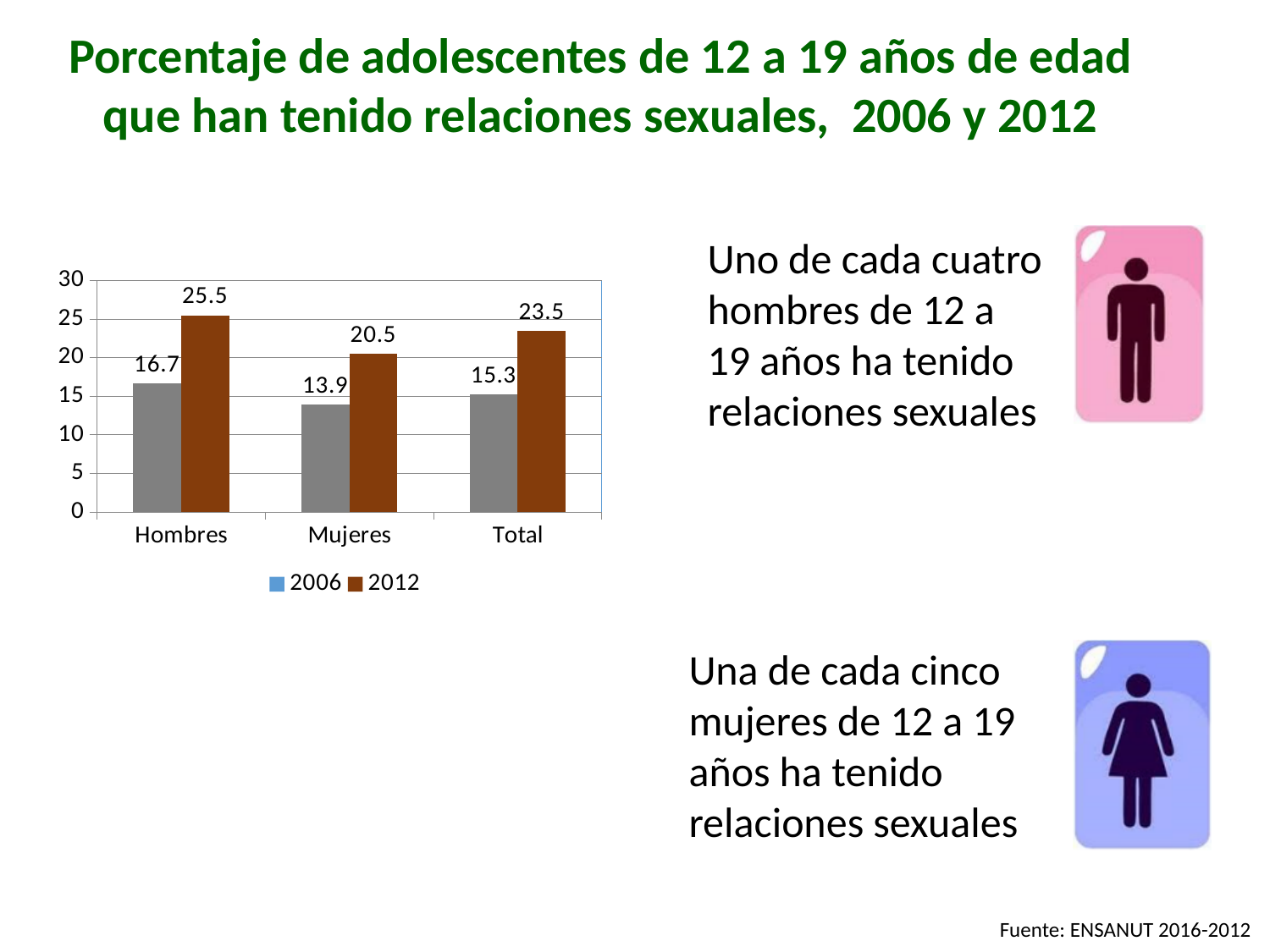
What kind of chart is shown on the slide? Bar chart What is the difference between the 2012 values for Hombres and Mujeres? 5 Which category has the lowest value in the 2006 series? Mujeres What is the value for Hombres in the 2006 series? 16.7 Which is larger, the 2012 value for Total or the 2012 value for Mujeres? Total What is the difference between the 2012 and 2006 values for Hombres? 8.8 What is the value for Mujeres in the 2012 series? 20.5 Which series is shown in brown in the legend? 2012 What is the value for Total in the 2006 series? 15.3 Which category has the highest value in the 2012 series? Hombres How many series does the legend list? 2 How many categories are shown on the x axis? 3